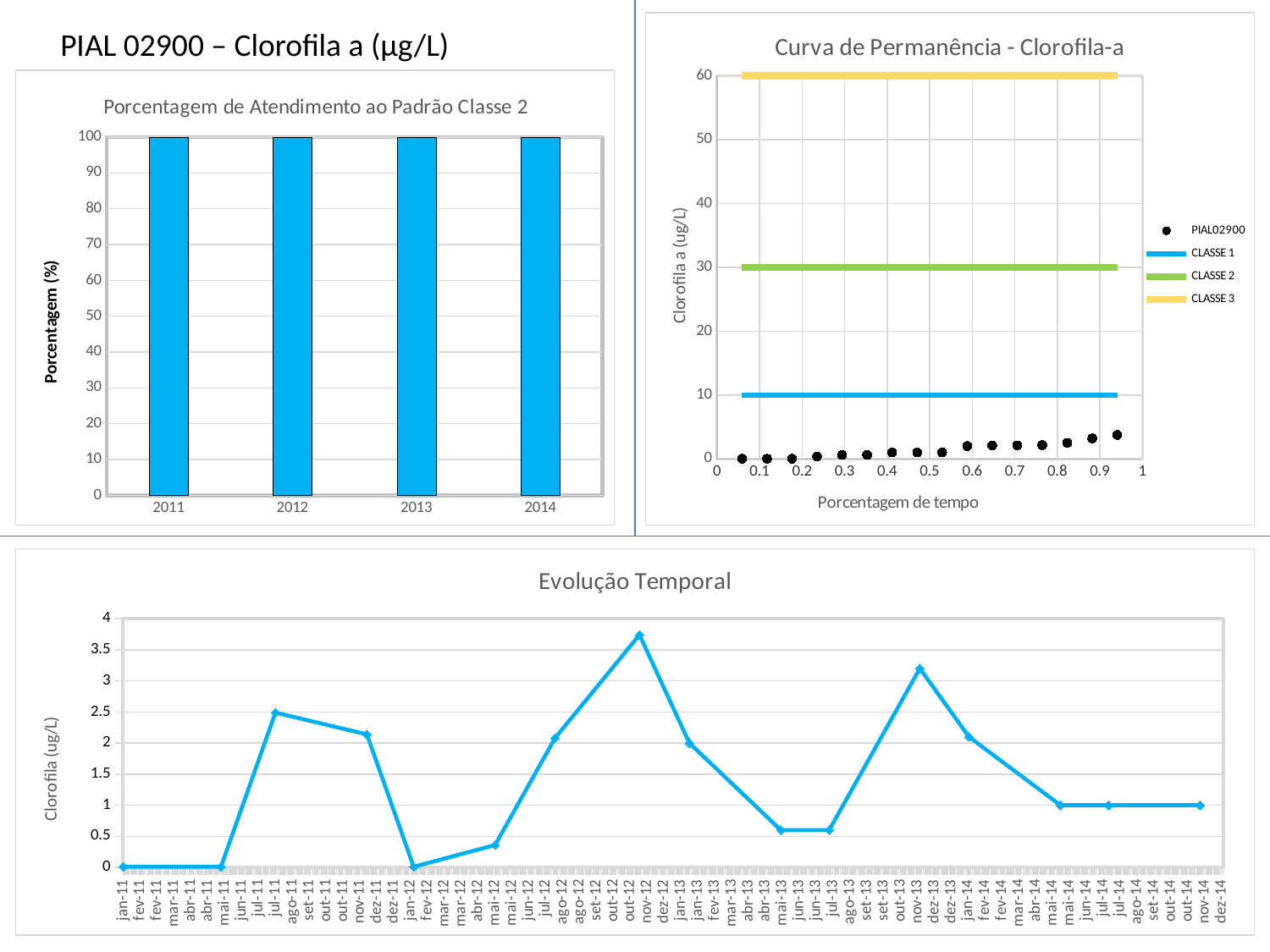
In the 'Curva de Permanência - Clorofila-a' chart, which is higher, the CLASSE 1 line or the CLASSE 2 line? CLASSE 2 In the 'Evolução Temporal' chart, is the value for jun-13 greater or less than 1? less In the 'Curva de Permanência - Clorofila-a' chart, at what Clorofila a value is the CLASSE 2 line drawn? 30 In the 'Evolução Temporal' chart, which month has the highest Clorofila value? nov-12 In the 'Porcentagem de Atendimento ao Padrão Classe 2' chart, what is the difference between the values for 2011 and 2014? 0 In the 'Curva de Permanência - Clorofila-a' chart, at what Clorofila a value is the CLASSE 3 line drawn? 60 In the 'Porcentagem de Atendimento ao Padrão Classe 2' chart, how many years are plotted? 4 In the 'Evolução Temporal' chart, is the value for nov-12 greater or less than 3.5? greater In the 'Curva de Permanência - Clorofila-a' chart, how many series does the legend list? 4 In the 'Porcentagem de Atendimento ao Padrão Classe 2' chart, what is the value for 2013? 100 In the 'Porcentagem de Atendimento ao Padrão Classe 2' chart, what kind of chart is shown? bar chart In the 'Curva de Permanência - Clorofila-a' chart, what is the label of the x axis? Porcentagem de tempo